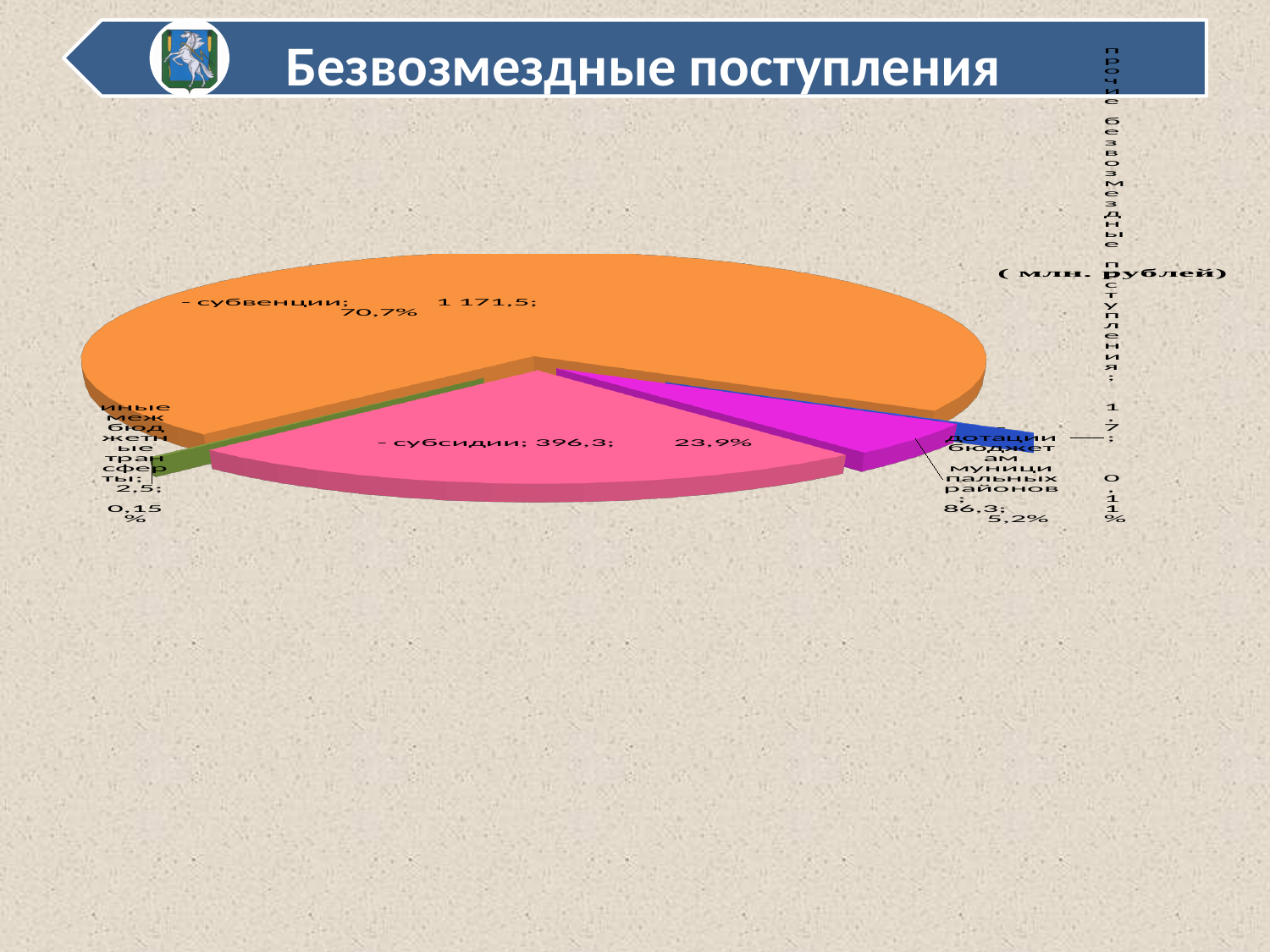
What is the value for субвенции? 1 171,5 What is the value for иные межбюджетные трансферты? 2,5 How many slices does the pie chart have? 5 What share of the pie does дотации бюджетам муниципальных районов represent? 5,2% Which is larger, субсидии or дотации бюджетам муниципальных районов? субсидии What is the value for дотации бюджетам муниципальных районов? 86,3 What share of the pie does субсидии represent? 23,9% What kind of chart is shown on the slide? pie chart What is the difference between the values for субвенции and субсидии? 775,2 What is the value for субсидии? 396,3 What share of the pie does субвенции represent? 70,7% Which category has the largest slice of the pie? субвенции